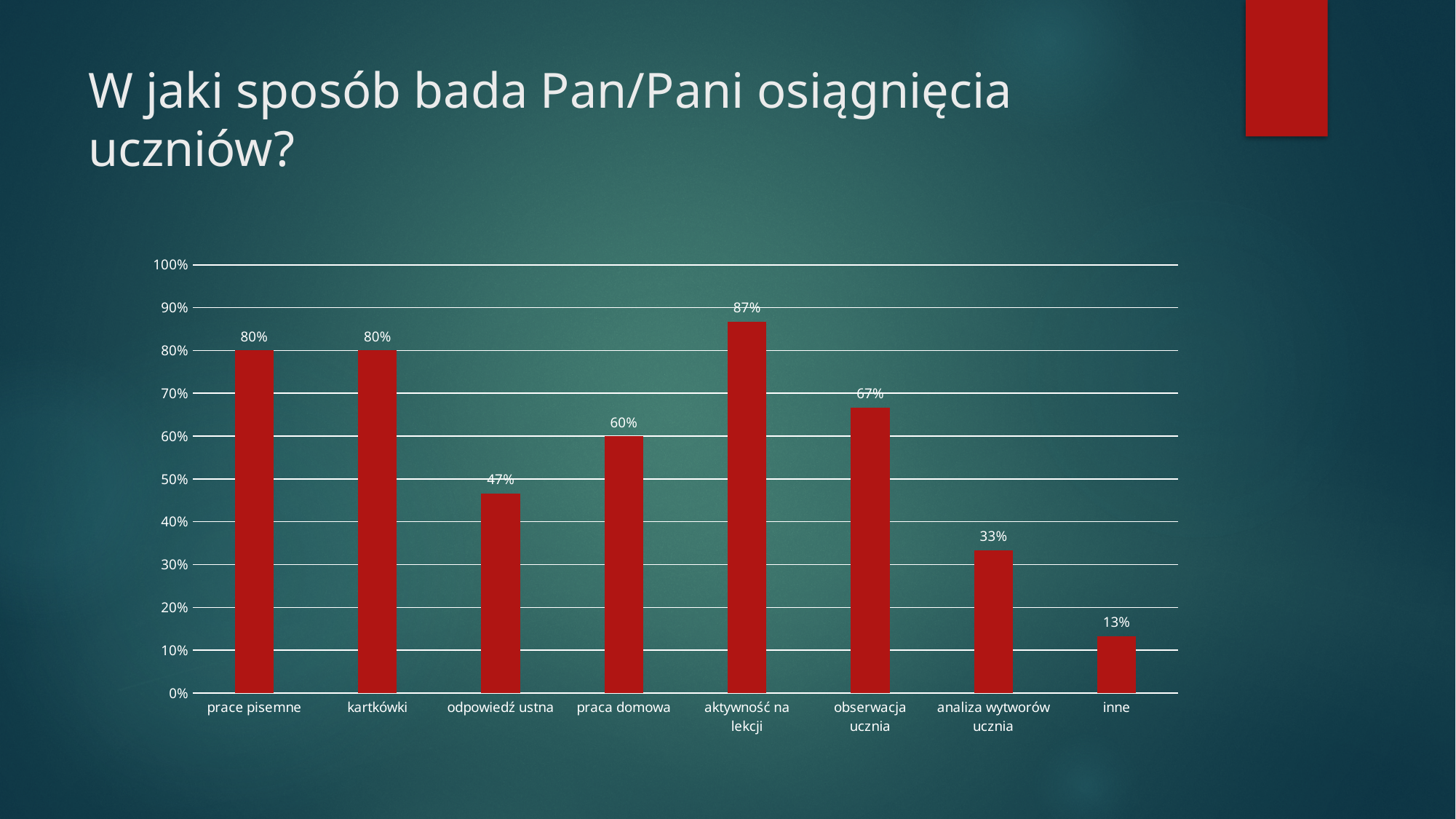
What kind of chart is shown on the slide? bar chart Which category has the highest value? aktywność na lekcji What is the value for "inne"? 13% What colour are the bars in the chart? red Which is larger, the value for "praca domowa" or the value for "obserwacja ucznia"? obserwacja ucznia Is the value for "kartkówki" greater or less than 70%? greater What is the value for "aktywność na lekcji"? 87% What is the title of the slide? W jaki sposób bada Pan/Pani osiągnięcia uczniów? What is the difference between the values for "obserwacja ucznia" and "analiza wytworów ucznia"? 34% What is the value for "odpowiedź ustna"? 47% How many categories are shown on the x axis? 8 Which category has the lowest value? inne